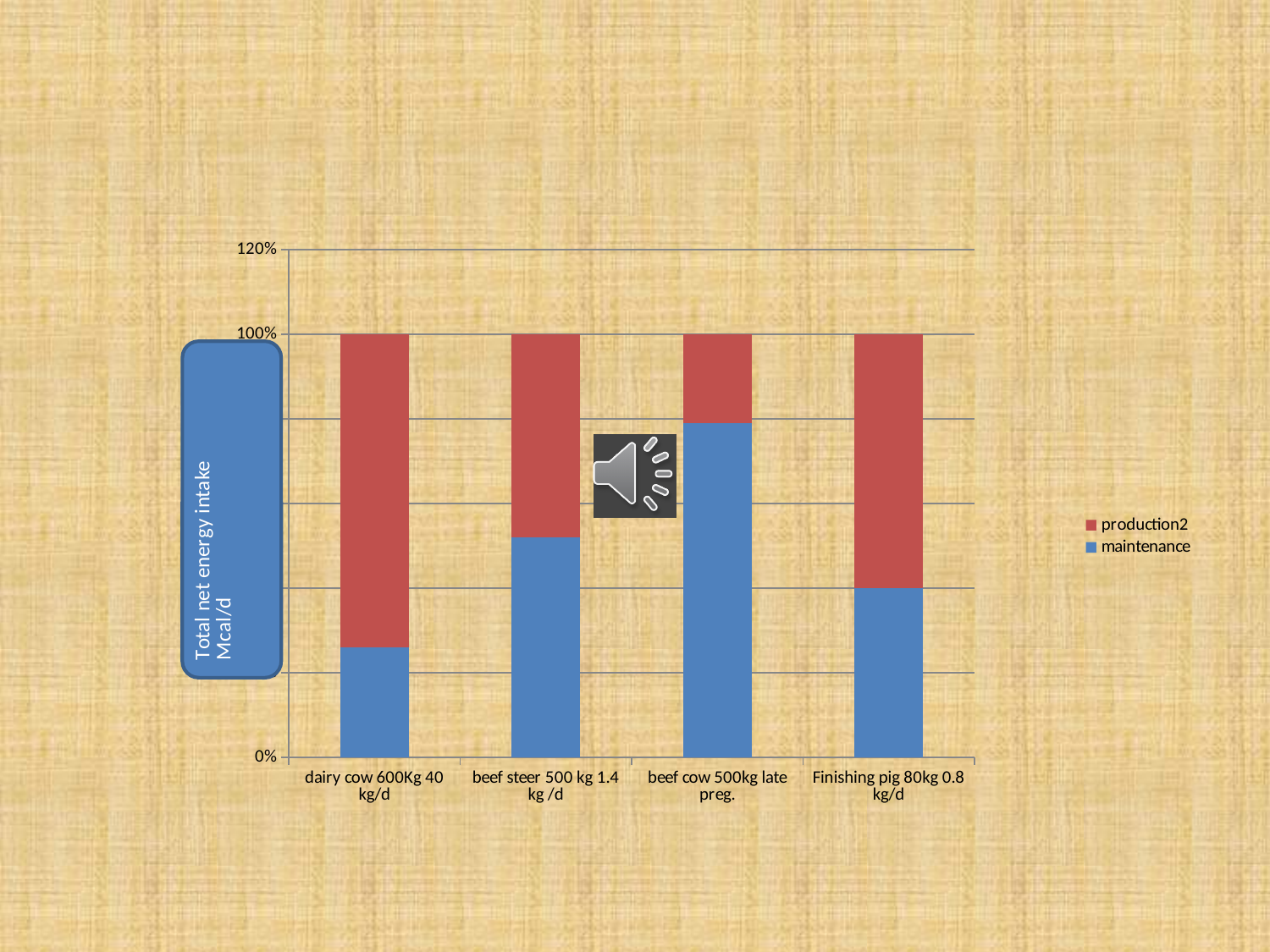
Which category has the largest maintenance share? beef cow 500kg late preg. Which has the larger production2 share: dairy cow 600Kg 40 kg/d or beef cow 500kg late preg.? dairy cow 600Kg 40 kg/d Which category has the largest production2 share? dairy cow 600Kg 40 kg/d Which has the larger maintenance share: beef steer 500 kg 1.4 kg /d or Finishing pig 80kg 0.8 kg/d? beef steer 500 kg 1.4 kg /d What are the two entries listed in the chart's legend? production2 and maintenance Which category has the smallest production2 share? beef cow 500kg late preg. How many series does the chart's legend list? 2 What is the label on the chart's vertical axis? Total net energy intake Mcal/d How many categories are shown on the x axis of the chart? 4 Which category has the smallest maintenance share? dairy cow 600Kg 40 kg/d What kind of chart is shown on the slide? bar chart What is the total height of the stacked bar for Finishing pig 80kg 0.8 kg/d? 100%